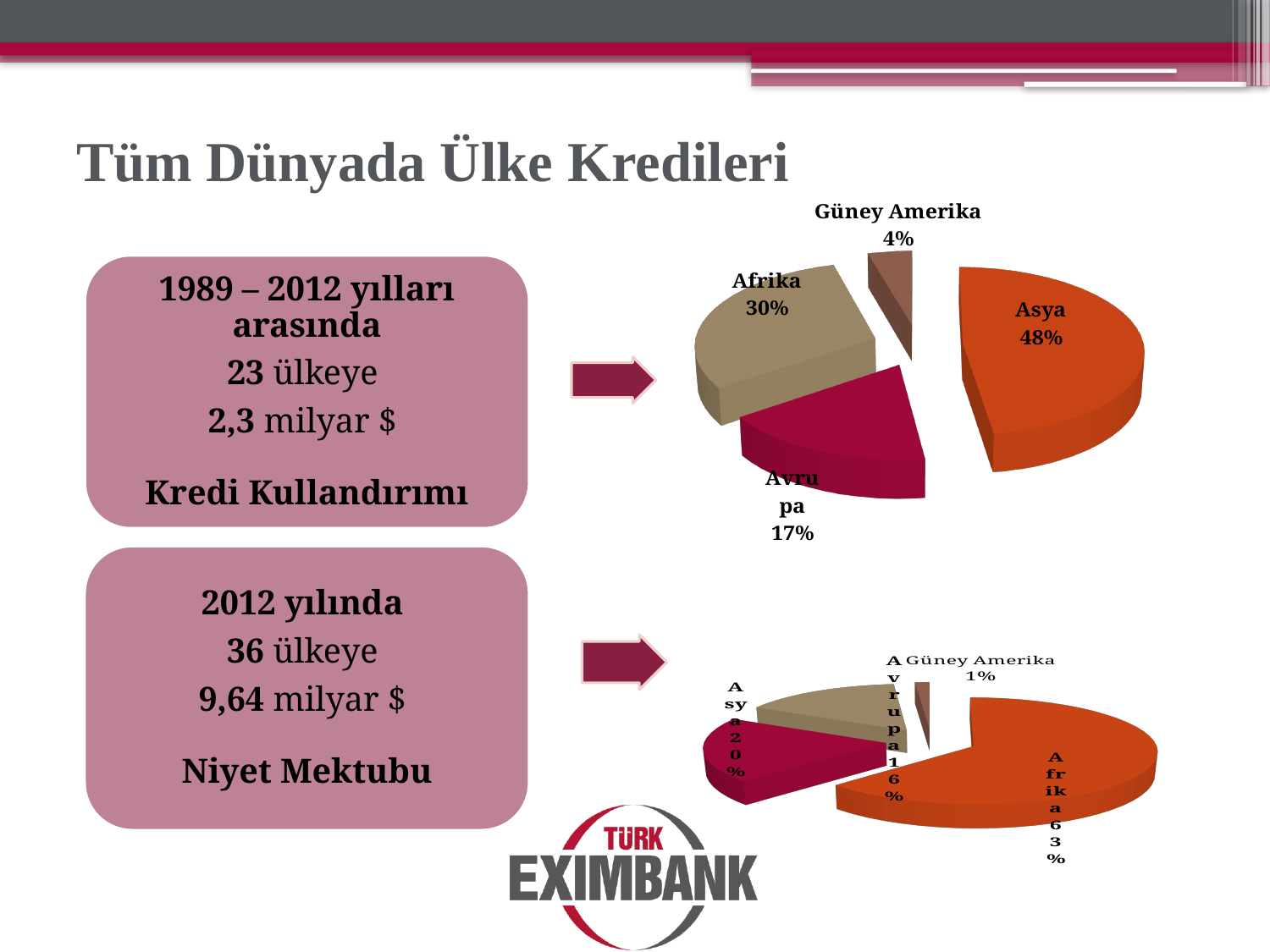
In the top pie chart, which region has the smallest share? Güney Amerika What type of chart is the top chart on the slide? Pie chart In the bottom pie chart, which region has the largest share? Afrika In the bottom pie chart, what is the difference between the shares of Afrika and Asya? 43% In the top pie chart, which region has the largest share? Asya In the top pie chart, how many slices are there? 4 In the top pie chart, what is the difference between the shares of Asya and Avrupa? 31% In the bottom pie chart, what share does Güney Amerika have? 1% In the bottom pie chart, which is larger, the share of Asya or the share of Avrupa? Asya In the top pie chart, what share does Afrika have? 30% In the top pie chart, what share does Asya have? 48% In the bottom pie chart, what share does Afrika have? 63%